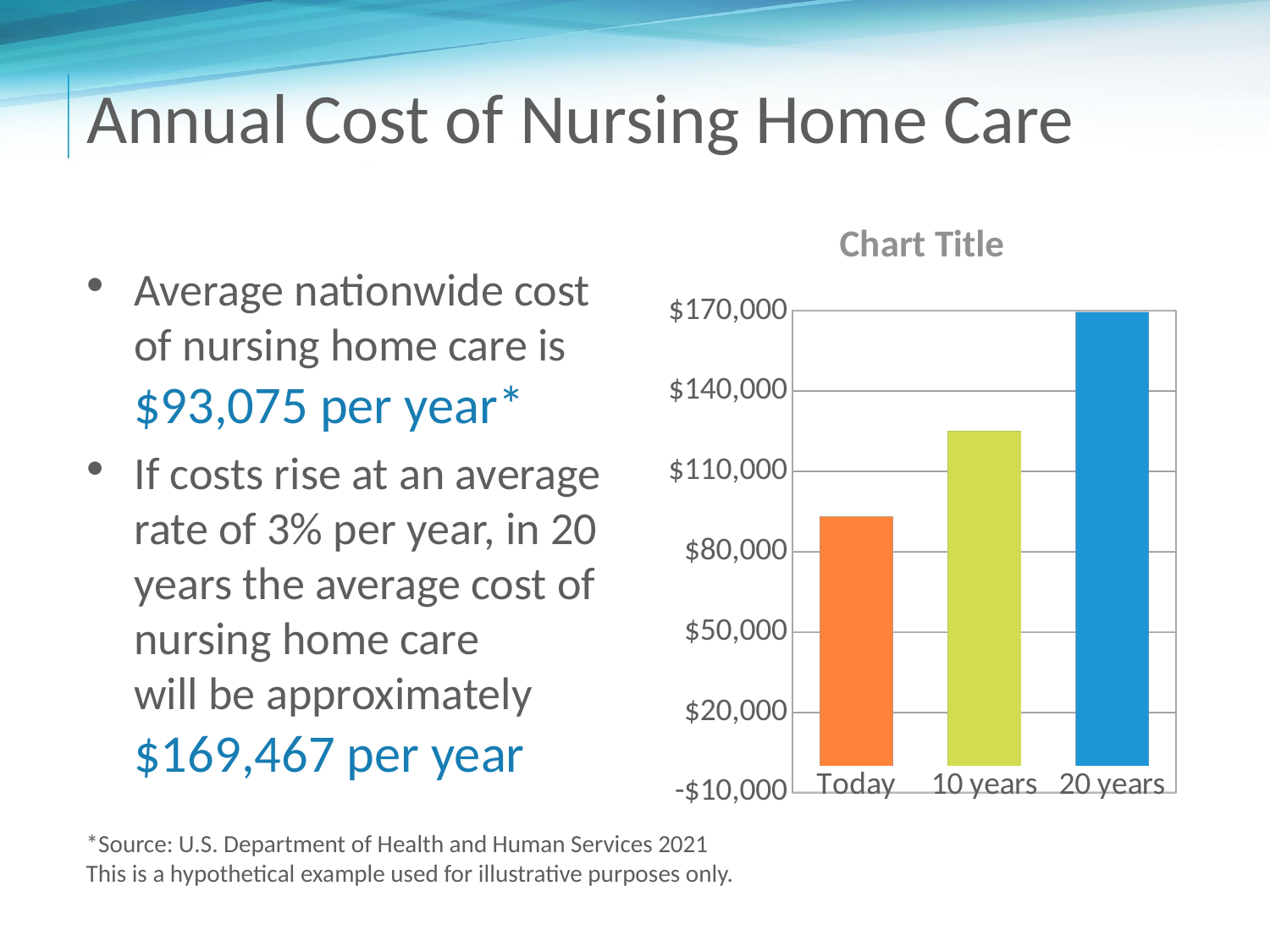
Is the value for Today greater or less than $80,000? greater Is the value for 10 years greater or less than $110,000? greater Which category has the lowest bar in the chart? Today Which category has the highest bar in the chart? 20 years Is the value for 20 years greater or less than $140,000? greater Which is larger, the value for 10 years or the value for 20 years? 20 years What colour is the bar for 20 years? blue What kind of chart is shown on the slide? bar chart Do the values rise or fall from Today to 20 years along the x axis? rise How many bars does the chart have? 3